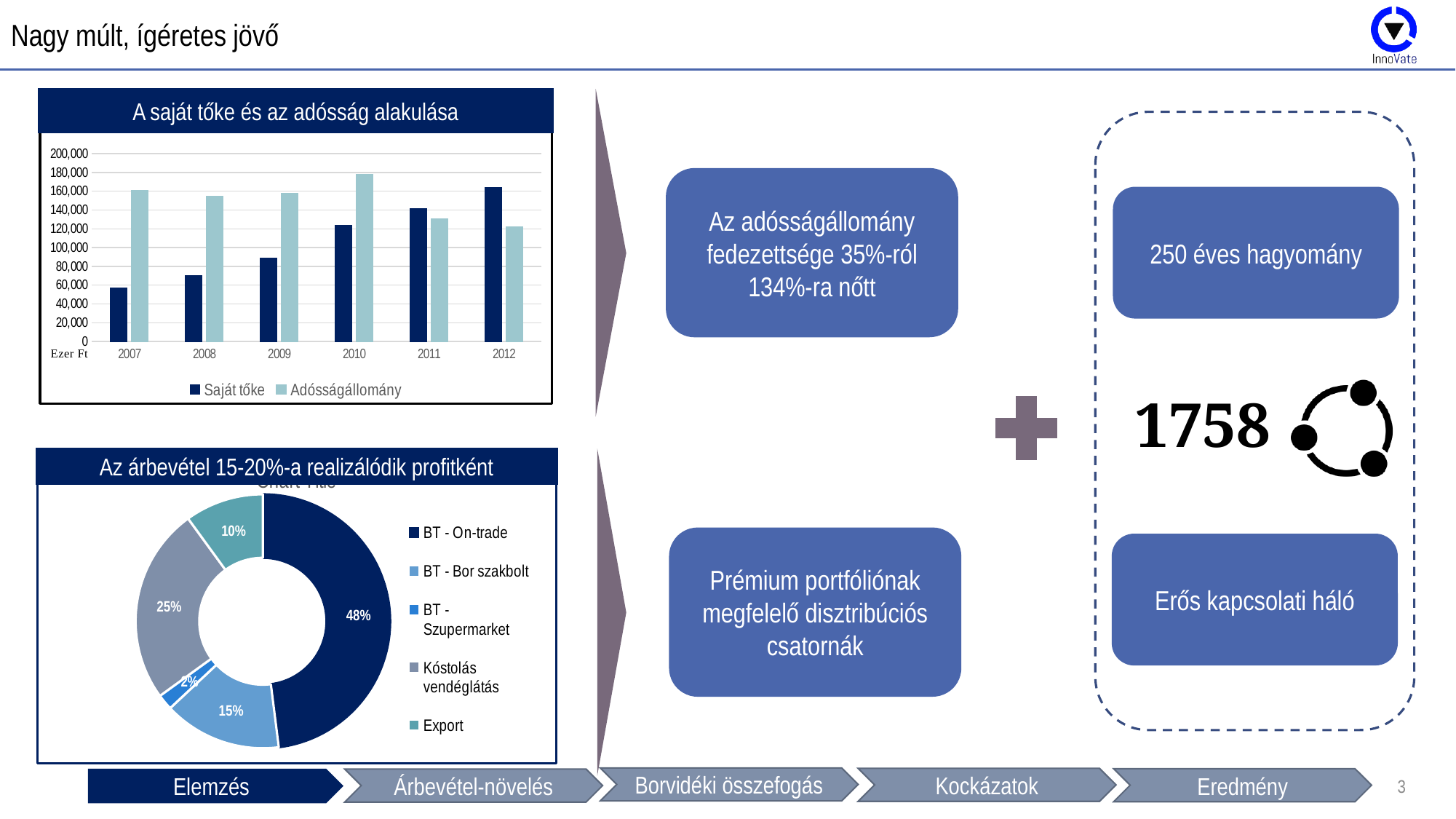
In the chart 'A saját tőke és az adósság alakulása', in which year is Adósságállomány highest? 2010 In the chart 'A saját tőke és az adósság alakulása', does Saját tőke rise or fall from 2007 to 2012? rise In the chart 'A saját tőke és az adósság alakulása', in which year is Saját tőke lowest? 2007 In the donut chart 'Az árbevétel 15-20%-a realizálódik profitként', what is the difference between the BT - On-trade share and the BT - Bor szakbolt share? 33 percentage points In the donut chart 'Az árbevétel 15-20%-a realizálódik profitként', which category has the largest share? BT - On-trade In the chart 'A saját tőke és az adósság alakulása', which is larger in 2012: Saját tőke or Adósságállomány? Saját tőke What kind of chart is 'A saját tőke és az adósság alakulása'? bar chart In the donut chart 'Az árbevétel 15-20%-a realizálódik profitként', what is the share of Kóstolás vendéglátás? 25% In the chart 'A saját tőke és az adósság alakulása', is the Saját tőke value for 2007 greater or less than 80,000? less In the chart 'A saját tőke és az adósság alakulása', how many series does the legend list? 2 In the chart 'A saját tőke és az adósság alakulása', how many years are shown on the x axis? 6 In the chart 'A saját tőke és az adósság alakulása', is the Adósságállomány value for 2010 greater or less than 160,000? greater